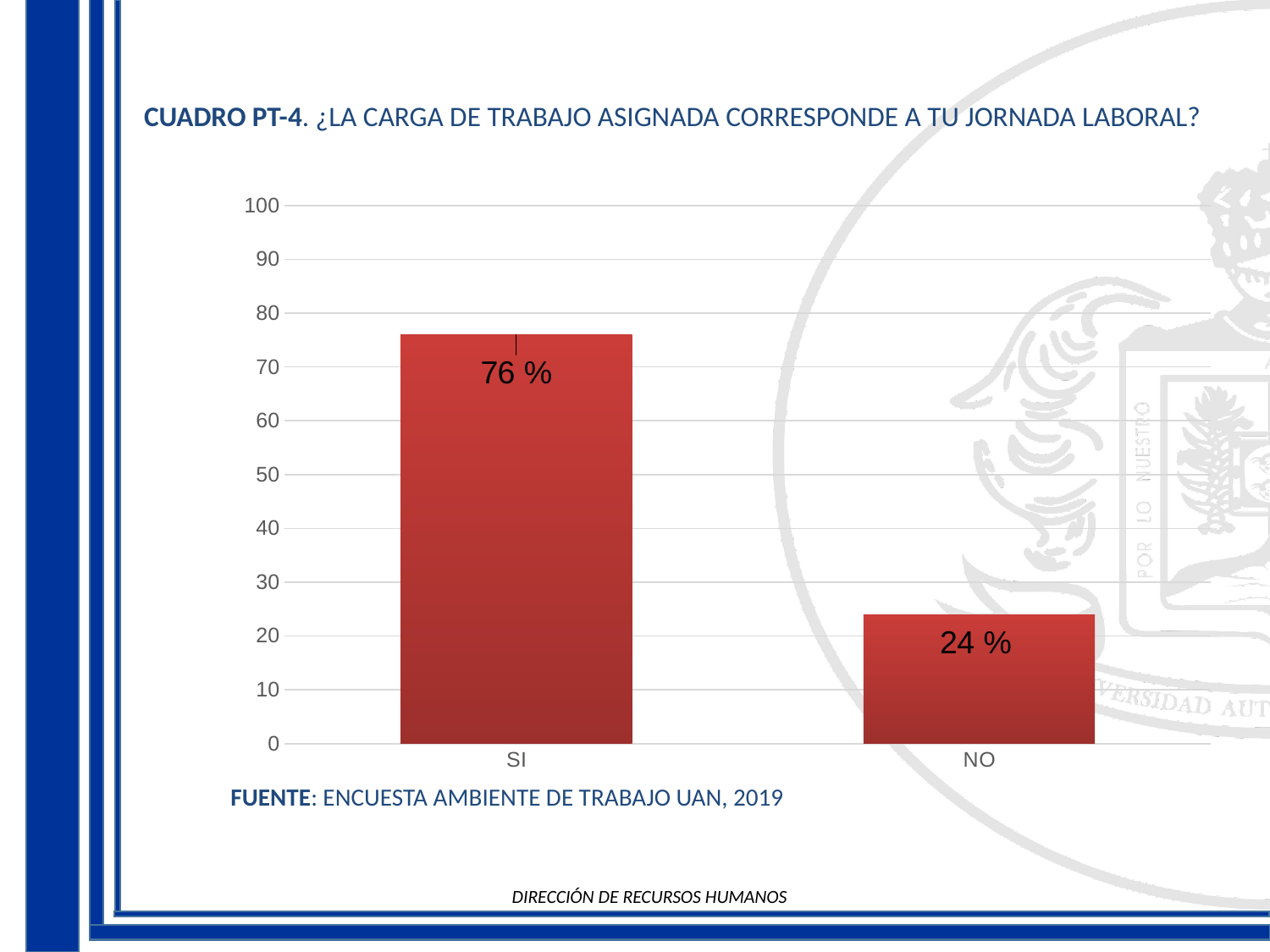
What is the maximum value shown on the y axis? 100 Which category has the lowest value? NO Is the value for NO greater or less than 30? less Which is larger, the value for SI or the value for NO? SI Which category has the highest value? SI What kind of chart is shown on the slide? bar chart What is the value for NO? 24 % What is the value for SI? 76 % How many categories are shown on the x axis? 2 Is the value for SI greater or less than 70? greater What is the difference between the values for SI and NO? 52 % What is the source cited below the chart? ENCUESTA AMBIENTE DE TRABAJO UAN, 2019